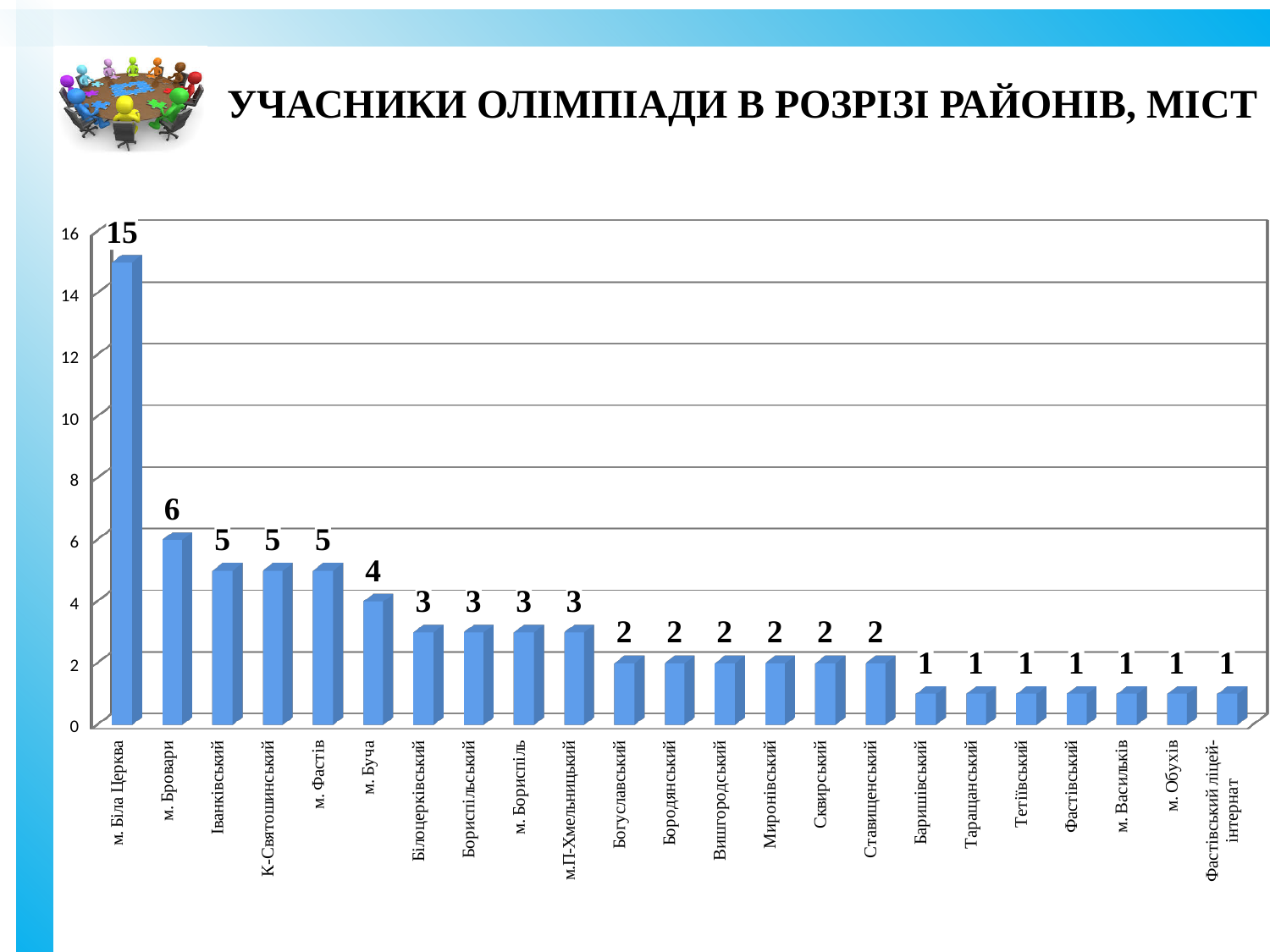
What kind of chart is shown on the slide? bar chart What is the value for м. Бровари? 6 What is the value for м. Буча? 4 What is the value for м. Біла Церква? 15 Which is larger, the value for Іванківський or the value for Богуславський? Іванківський What is the difference between the values for м. Біла Церква and м. Бровари? 9 What is the title of the slide? УЧАСНИКИ ОЛІМПІАДИ В РОЗРІЗІ РАЙОНІВ, МІСТ What is the difference between the values for м. Фастів and Білоцерківський? 2 What is the value for м. Обухів? 1 How many categories are shown on the x axis? 23 What is the value for Сквирський? 2 Which category has the highest value? м. Біла Церква